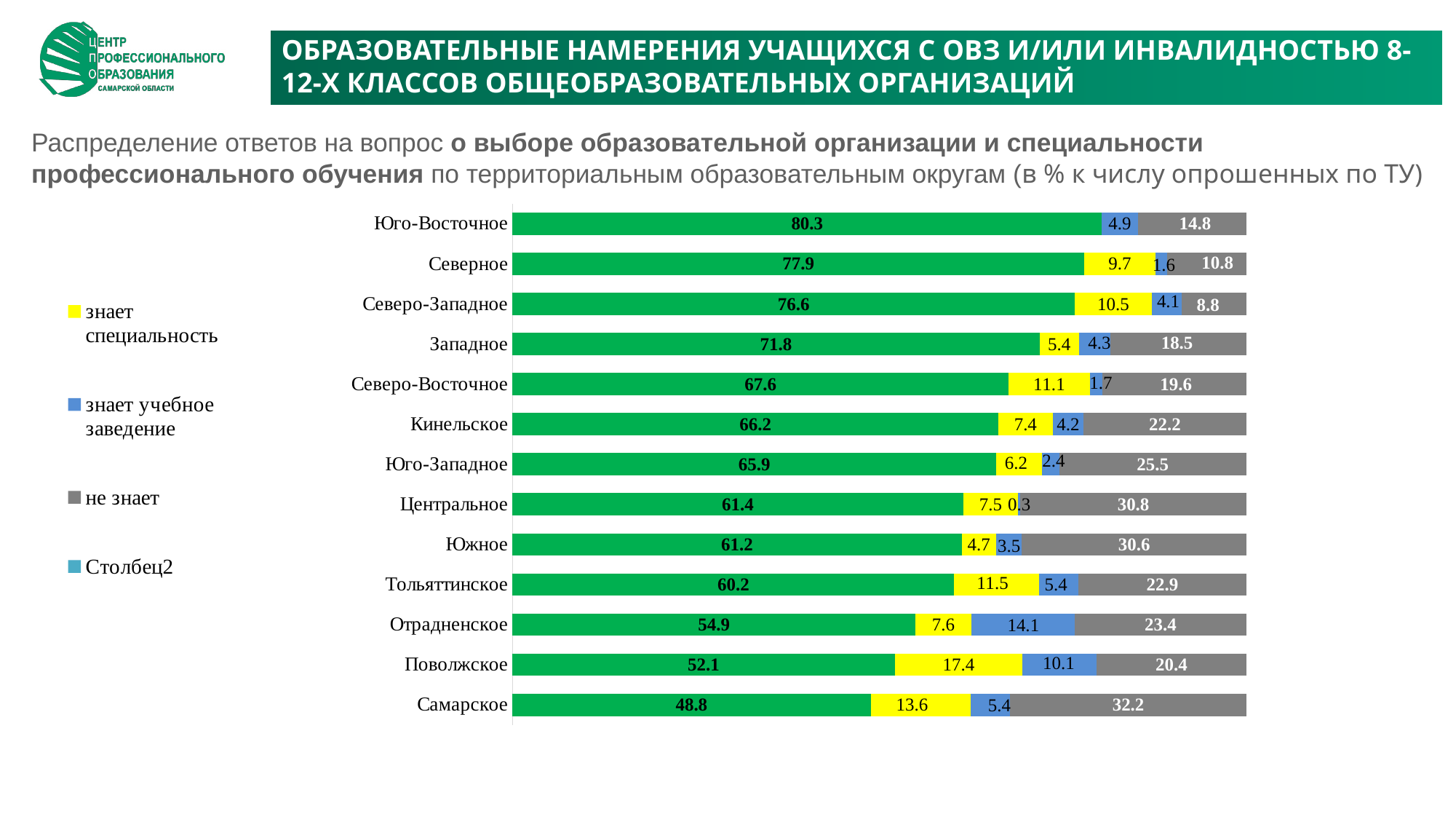
What kind of chart is shown on the slide? Stacked horizontal bar chart How many territorial districts (categories) are plotted in the chart? 13 How many entries does the chart legend list? 4 What is the value of "знает специальность" for Поволжское? 17.4 What is the difference between the green segment values for Юго-Восточное and Самарское? 31.5 What colour represents "не знает" in the legend? Grey What is the value of "не знает" for Самарское? 32.2 What is the value of "знает учебное заведение" for Отрадненское? 14.1 Which is larger, the "знает специальность" value for Северное or for Северо-Западное? Северо-Западное Which district has the lowest value for "знает учебное заведение"? Центральное Which district has the highest value for "не знает"? Самарское Which district has the highest value for "знает специальность"? Поволжское